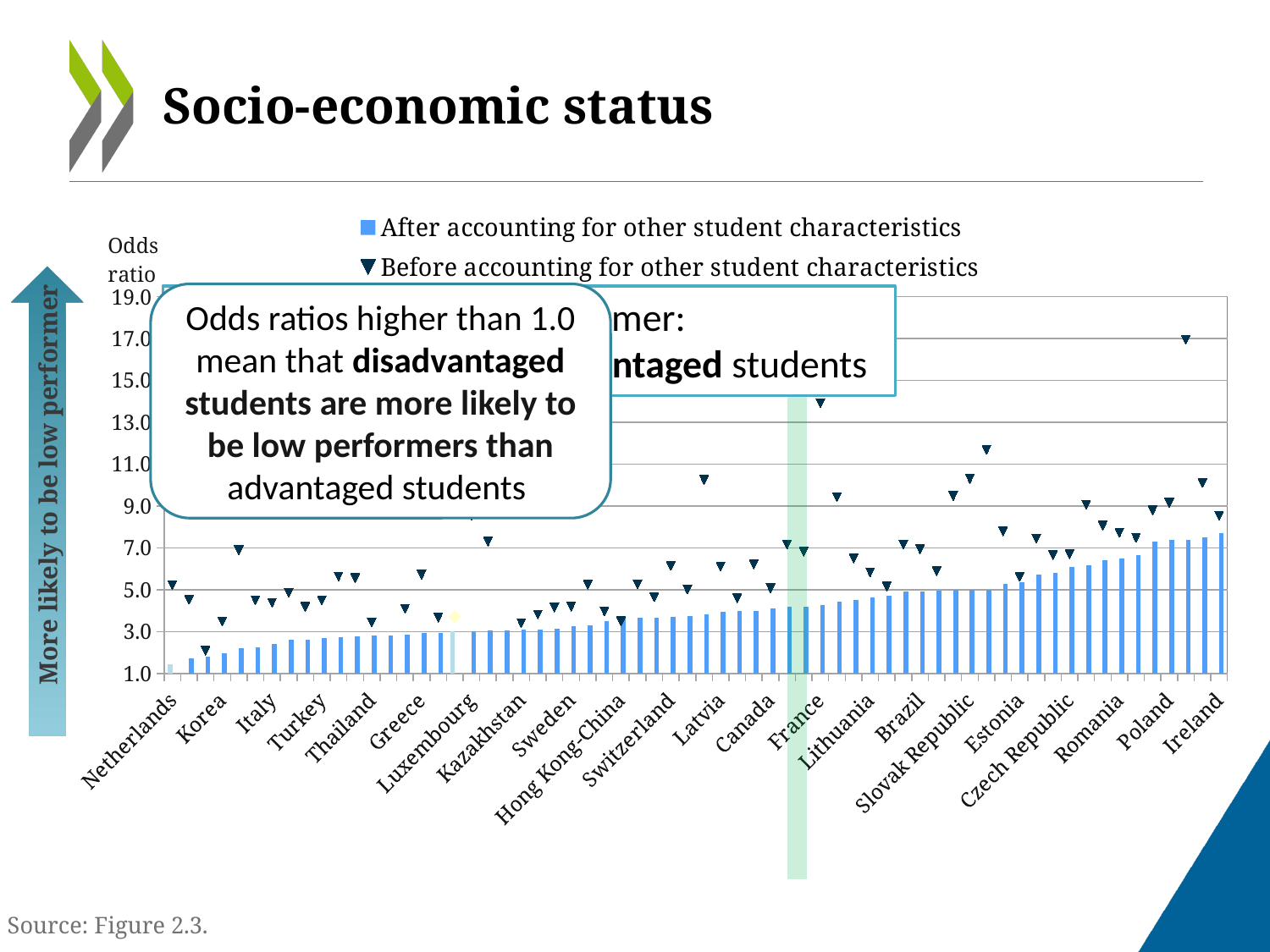
Is the bar value for Netherlands greater or less than 3.0? less Is the bar value for France greater or less than 5.0? less Which labelled country has the lowest bar for 'After accounting for other student characteristics'? Netherlands Which has the larger bar value, Korea or Poland? Poland How many series does the legend list? 2 What is the label on the vertical axis of the chart? Odds ratio Which series is shown with triangle markers according to the legend? Before accounting for other student characteristics What kind of chart is shown on the slide? bar chart Is the 'Before accounting for other student characteristics' value for Poland greater or less than 15.0? less Which labelled country has the highest bar for 'After accounting for other student characteristics'? Ireland Do the bar values rise or fall moving from left to right along the x axis? rise